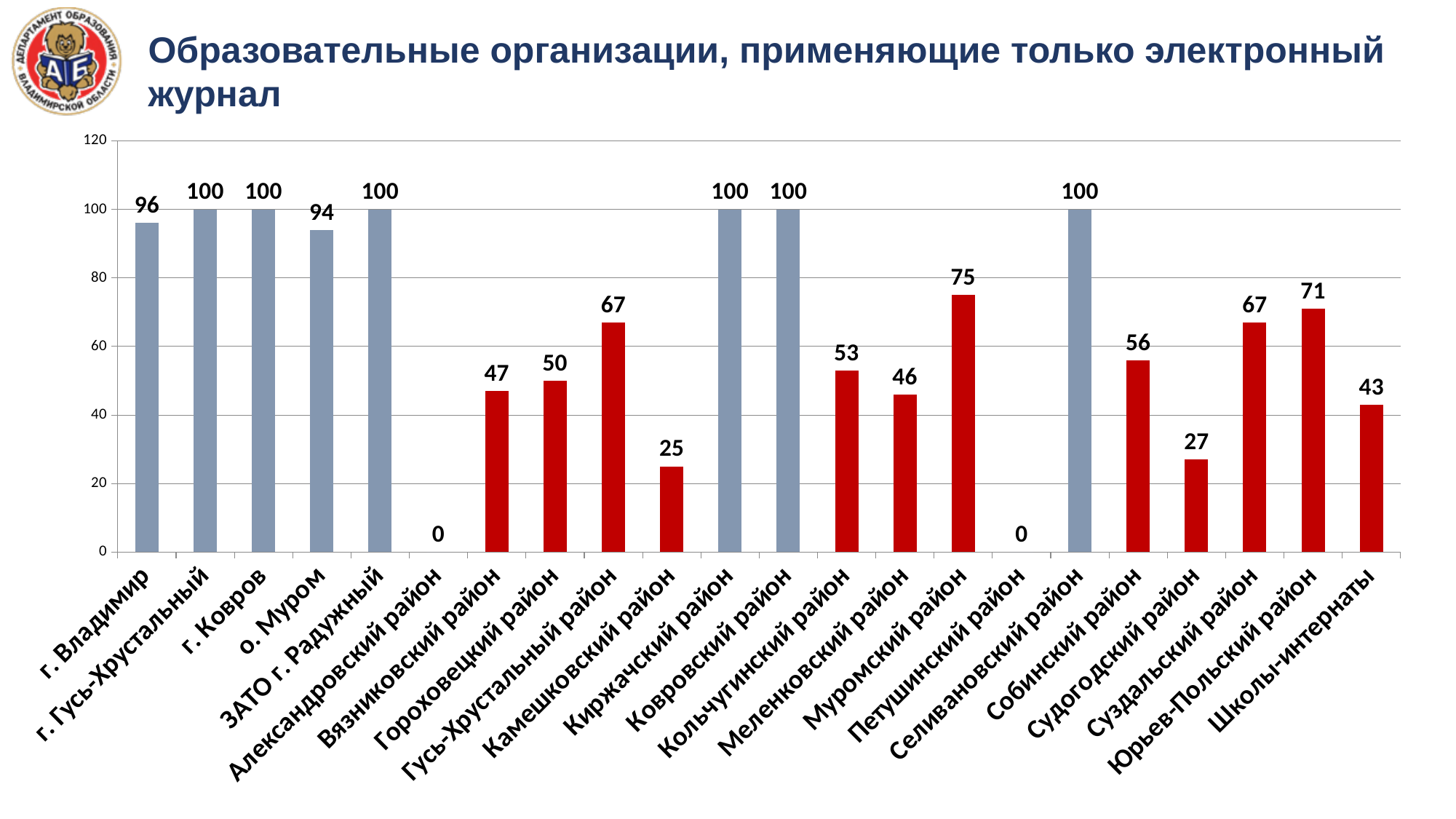
What is the value for Школы-интернаты? 43 What is the title of the chart on the slide? Образовательные организации, применяющие только электронный журнал What type of chart is shown on the slide? Bar chart What is the value for Судогодский район? 27 What is the value for Камешковский район? 25 What is the difference between the values for Юрьев-Польский район and Собинский район? 15 What is the value for Муромский район? 75 What is the value for о. Муром? 94 What is the value for г. Владимир? 96 Which has a larger value, Вязниковский район or Кольчугинский район? Кольчугинский район What is the lowest value shown in the chart? 0 How many categories are shown on the x axis? 22